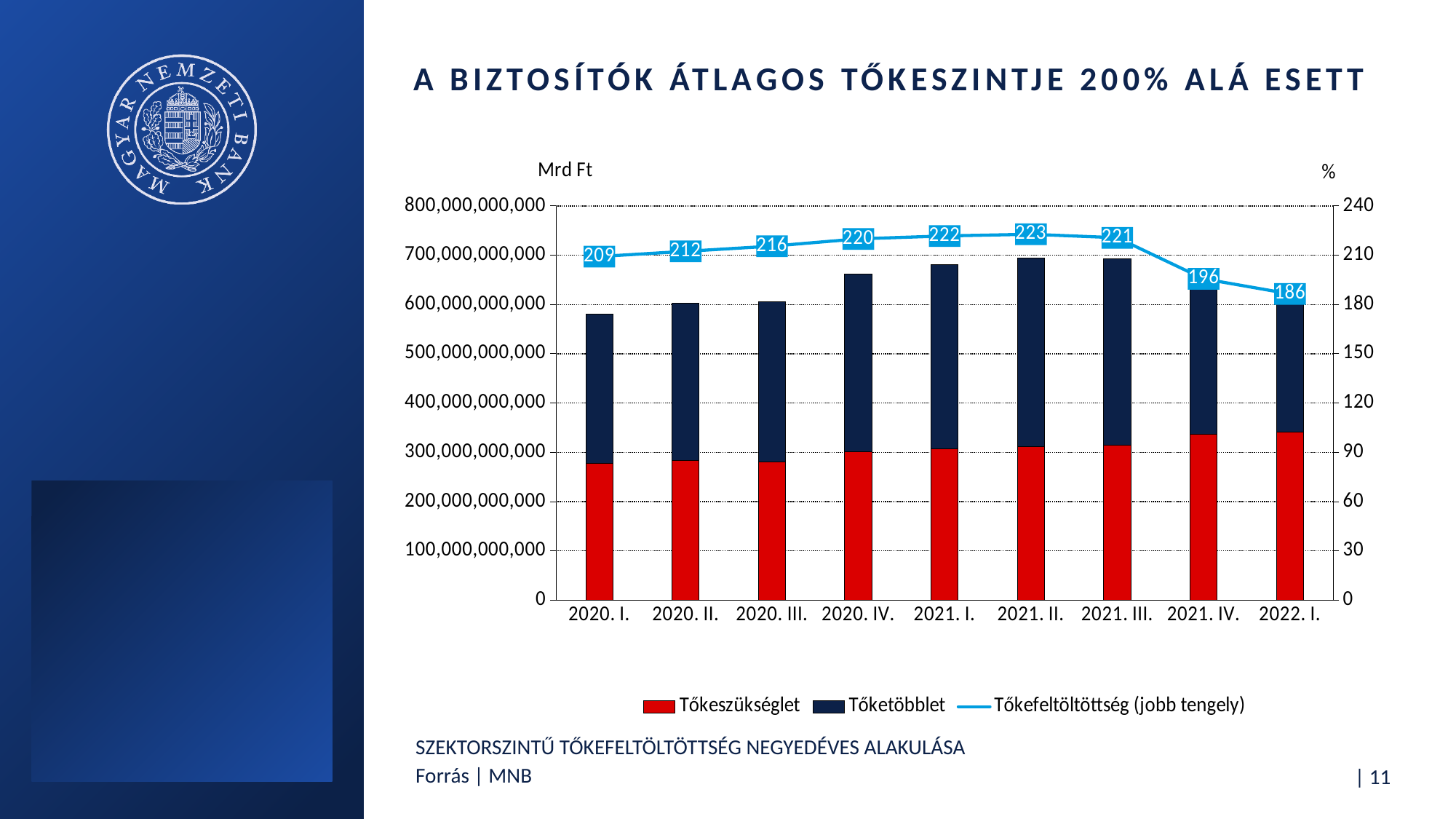
What is the difference between the Tőkefeltöltöttség values for 2021. II. and 2022. I.? 37 In which quarter is the Tőkefeltöltöttség line at its highest? 2021. II. What is the Tőkefeltöltöttség value for 2020. I.? 209 What kind of chart is shown on the slide? A combined stacked bar and line chart Is the Tőkeszükséglet value for 2020. I. greater or less than 300,000,000,000? less Is the total height of the stacked bar for 2021. II. greater or less than 600,000,000,000? greater What is the Tőkefeltöltöttség value for 2021. II.? 223 In which quarter is the Tőkefeltöltöttség line at its lowest? 2022. I. How many quarters are shown on the x axis? 9 How many series does the legend list? 3 What is the Tőkefeltöltöttség value for 2022. I.? 186 Which quarter has the higher Tőkefeltöltöttség value, 2020. I. or 2021. I.? 2021. I.